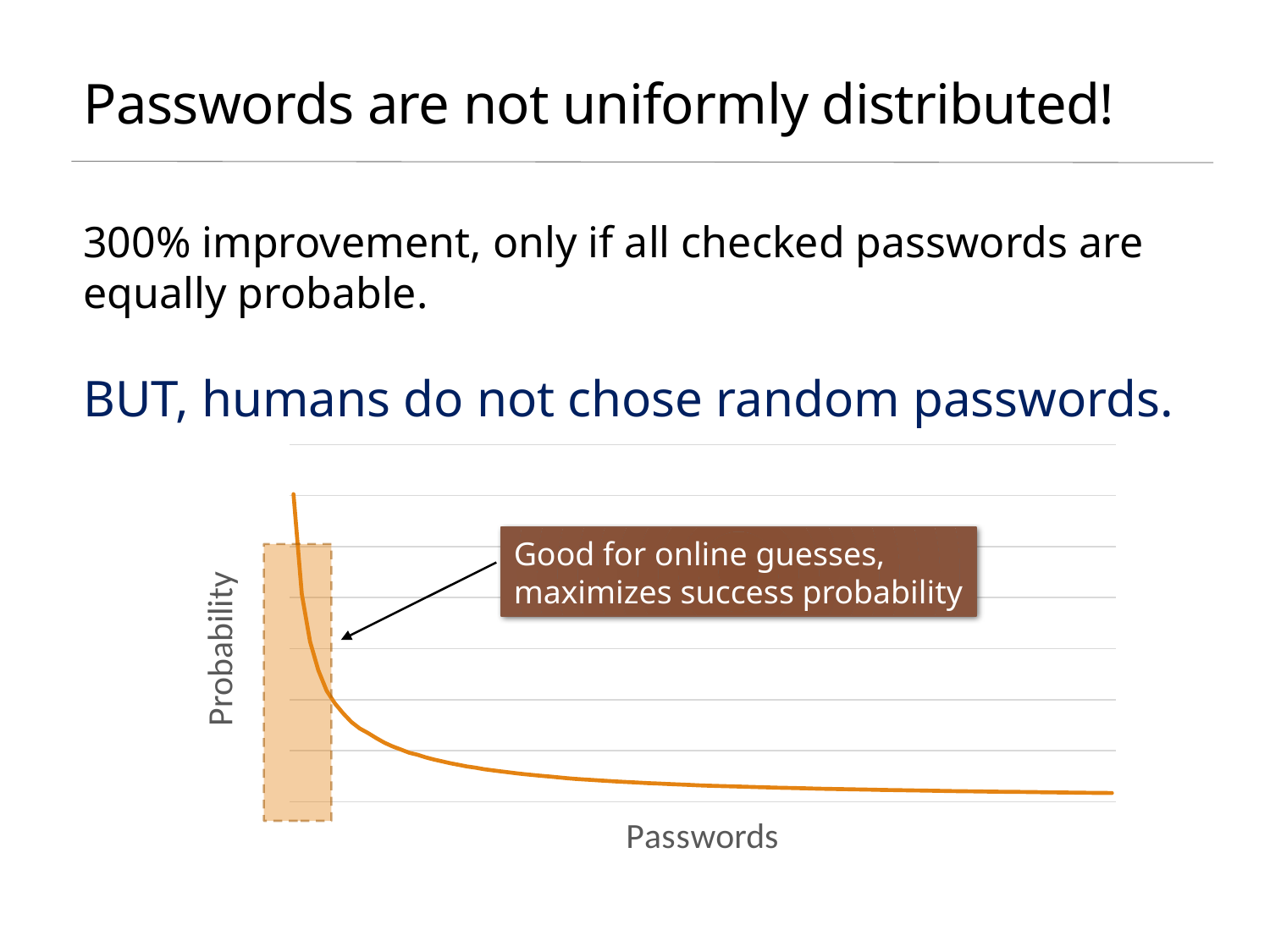
Is the probability for passwords at the left of the chart larger or smaller than for passwords at the right? larger What kind of chart is shown on the slide? line chart What is the label of the horizontal axis of the chart? Passwords Where along the x axis is the probability lowest: at the left end or the right end? right end What is the label of the vertical axis of the chart? Probability Do the values on the chart rise or fall along the x axis? fall Where along the x axis is the probability highest: at the left end or the right end? left end